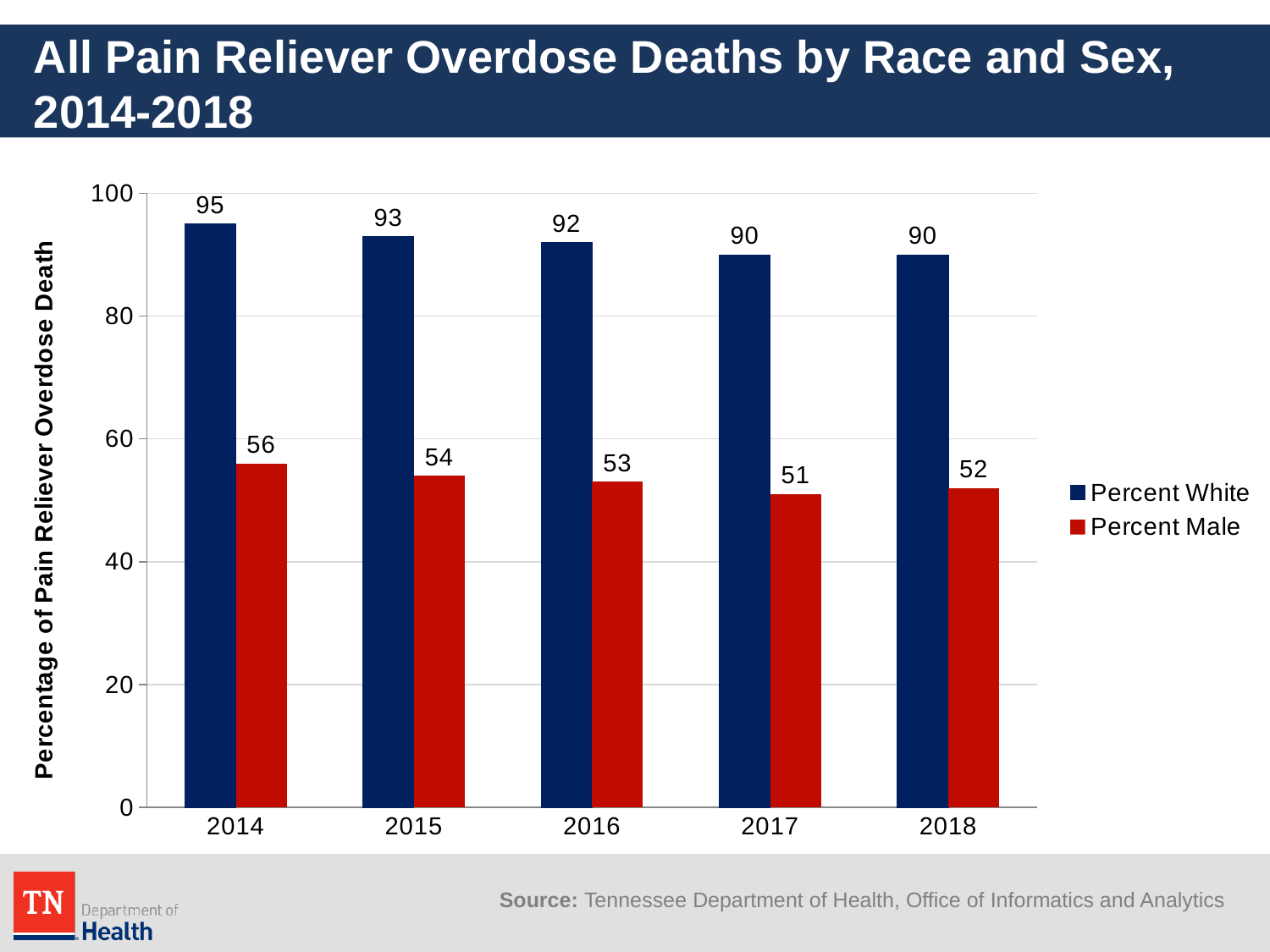
Which is larger, Percent Male in 2014 or Percent Male in 2015? Percent Male in 2014 What is the Percent Male value for 2018? 52 Does the Percent White value rise or fall from 2014 to 2017? Fall In which year is the Percent Male value lowest? 2017 By how much did Percent White fall from 2014 to 2018? 5 What is the difference between Percent White and Percent Male in 2016? 39 What kind of chart is shown on the slide? Bar chart In which year is the Percent White value highest? 2014 How many years are shown on the x axis? 5 How many series does the legend list? 2 What is the Percent White value for 2014? 95 What is the Percent Male value for 2017? 51